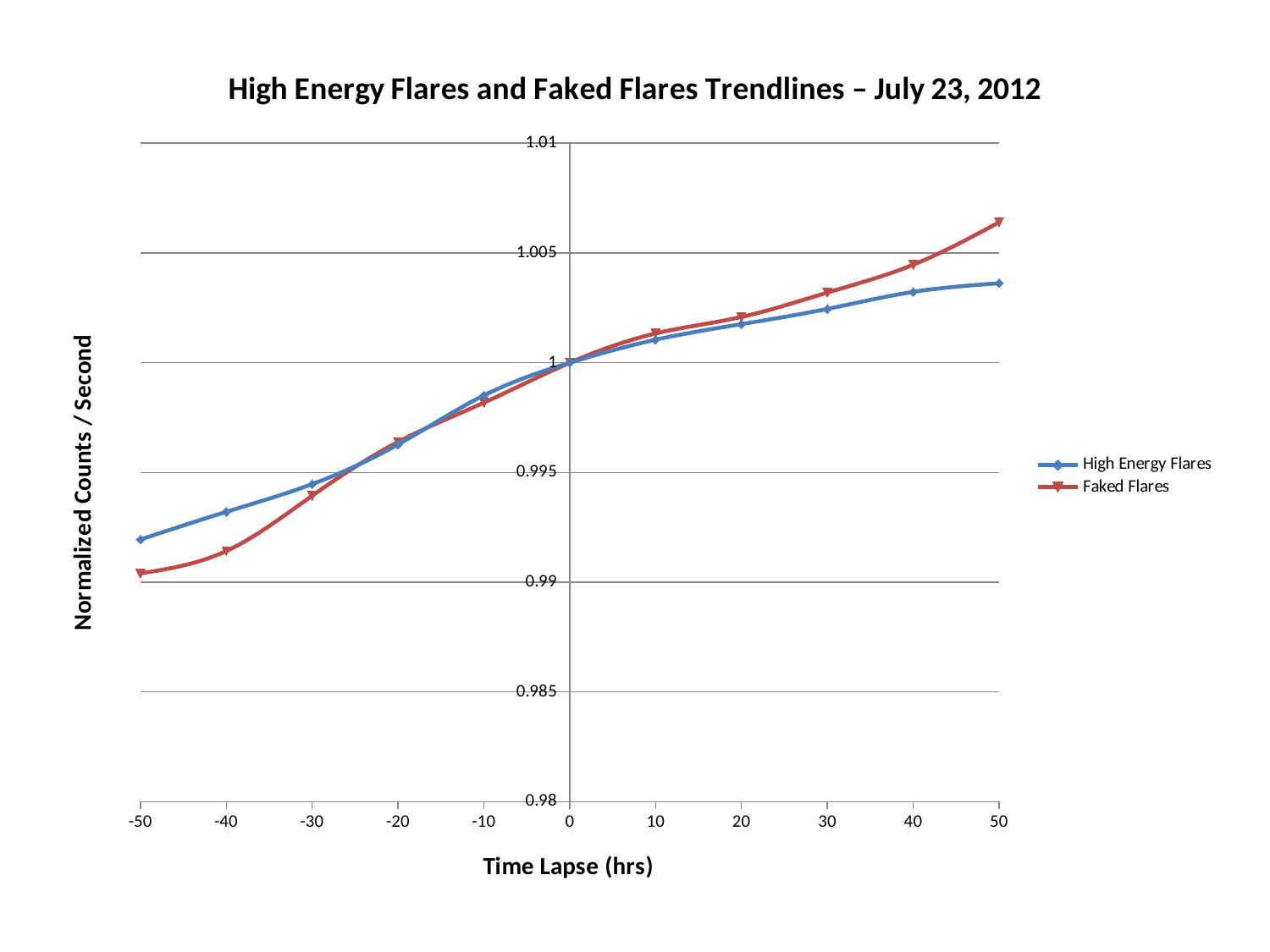
At a time lapse of 50 hrs, which series has the higher value, High Energy Flares or Faked Flares? Faked Flares Is the value for Faked Flares at 50 hrs greater or less than 1.005? greater How many time-lapse points are plotted for each series? 11 How many series does the legend list? 2 Is the value for High Energy Flares at -30 hrs greater or less than 0.995? less What are the two series named in the legend? High Energy Flares and Faked Flares At a time lapse of -50 hrs, which series has the higher value, High Energy Flares or Faked Flares? High Energy Flares Is the value for High Energy Flares at -50 hrs greater or less than 0.99? greater Do the values for Faked Flares rise or fall as the time lapse increases from -50 to 50 hrs? rise What is the value of High Energy Flares at a time lapse of 0 hrs? 1 What kind of chart is shown on the slide? line chart